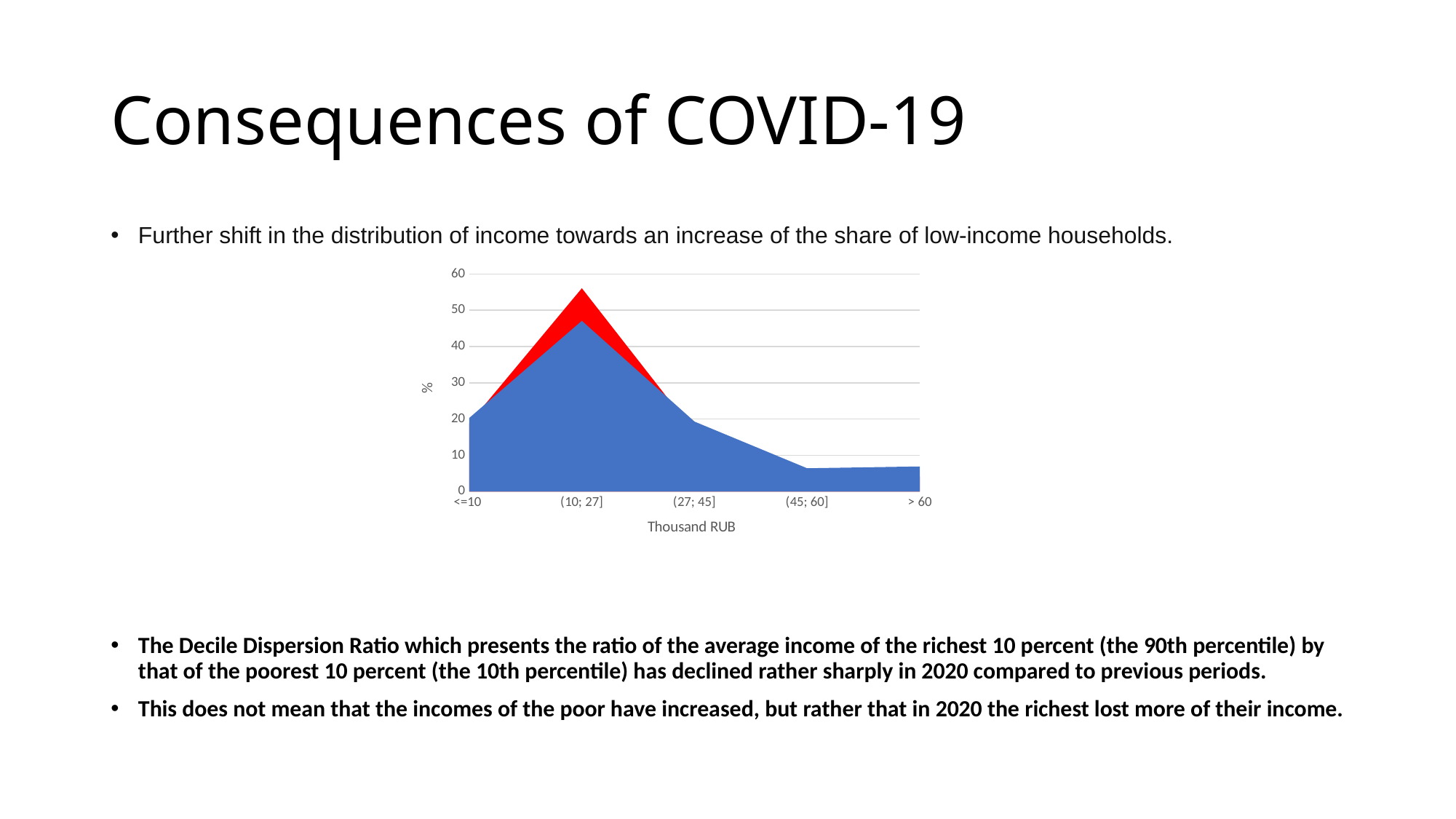
How many income categories are shown on the x axis of the chart? 5 Is the peak of the red series at (10; 27] greater or less than 50? greater Is the value of the blue series for (10; 27] greater or less than 40? greater Which income category has the highest value in the chart? (10; 27] Is the value for <=10 greater or less than 10? greater Do the values rise or fall along the x axis from (10; 27] to (45; 60]? fall What is the label of the x axis of the chart? Thousand RUB What kind of chart is shown on the slide? area chart What is the label of the y axis of the chart? % Which category has the larger value, (10; 27] or (27; 45]? (10; 27]